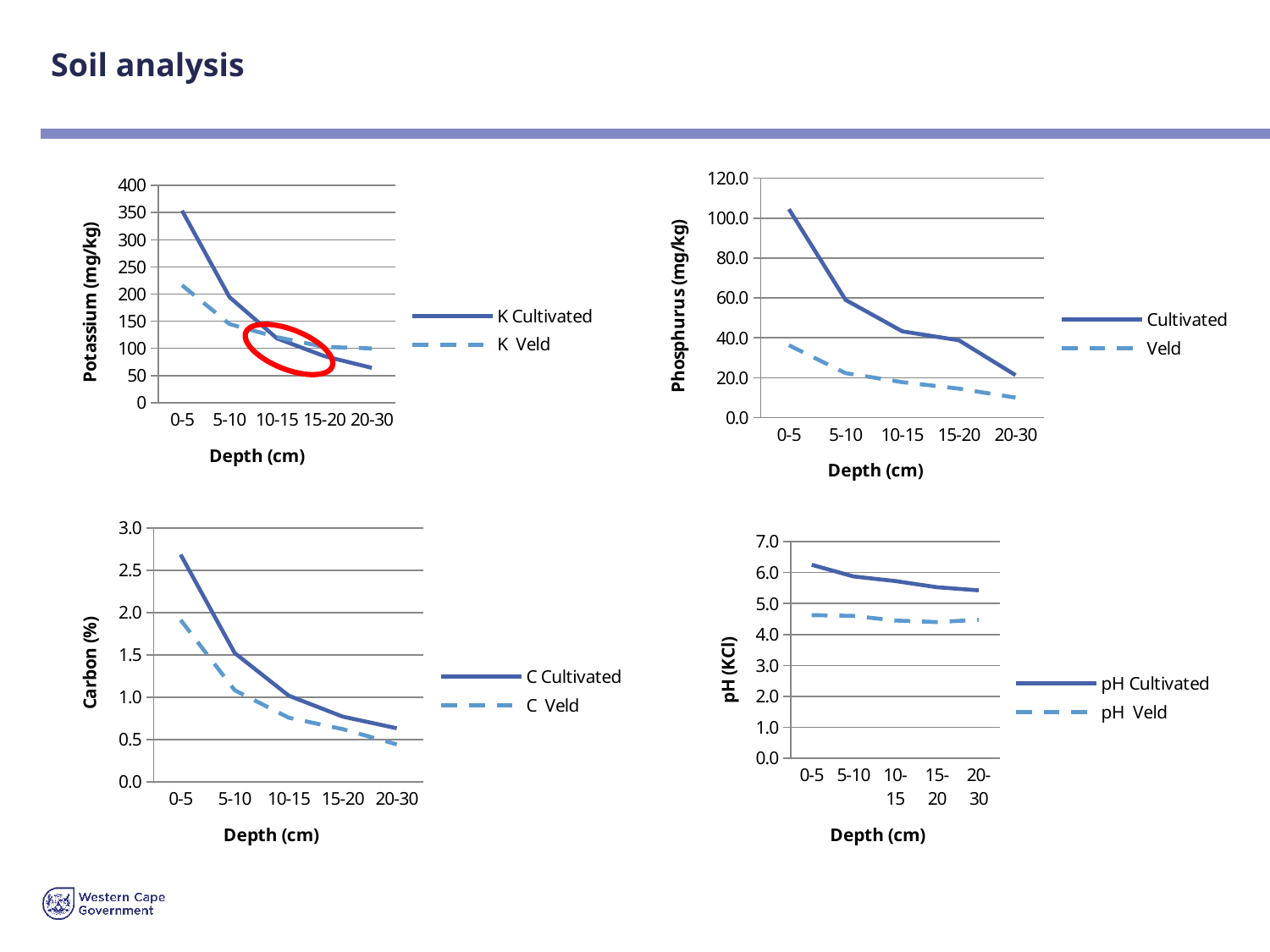
How many series does the legend of the top-right chart (Phosphurus) list? 2 In the top-right chart (Phosphurus), does the Cultivated series rise or fall as depth increases from 0-5 to 20-30? Fall In the top-left chart (Potassium), is the value for K Veld at depth 0-5 greater or less than 250? less In the bottom-left chart (Carbon), is the value for C Cultivated at depth 0-5 greater or less than 2.0? greater In the bottom-right chart (pH), is the value for pH Veld at depth 0-5 greater or less than 5.0? less In the bottom-left chart (Carbon), at which depth is the C Veld value lowest? 20-30 In the bottom-right chart (pH), which series has the larger value at depth 20-30, pH Cultivated or pH Veld? pH Cultivated In the top-left chart (Potassium), which series has the larger value at depth 0-5, K Cultivated or K Veld? K Cultivated How many depth categories are shown on the x axis of the bottom-left chart (Carbon)? 5 What kind of chart is the top-left chart (Potassium)? Line chart